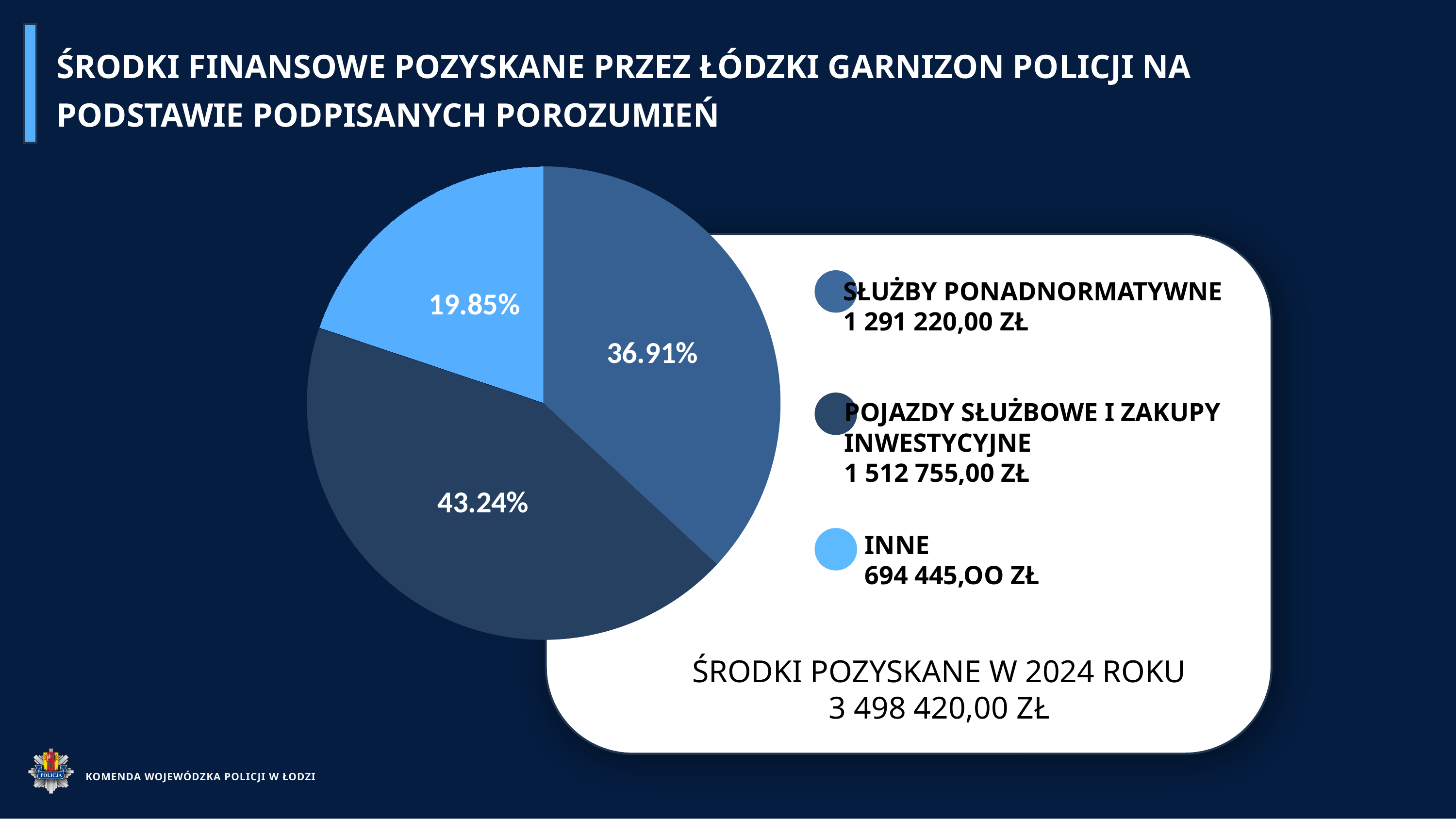
What share of the pie does INNE represent? 19.85% How many slices does the pie chart have? 3 What colour is the INNE slice in the pie chart? light blue Which category has the largest slice of the pie? POJAZDY SŁUŻBOWE I ZAKUPY INWESTYCYJNE What share of the pie does SŁUŻBY PONADNORMATYWNE represent? 36.91% What amount is listed in the legend for SŁUŻBY PONADNORMATYWNE? 1 291 220,00 ZŁ Which is larger: the share for SŁUŻBY PONADNORMATYWNE or the share for INNE? SŁUŻBY PONADNORMATYWNE What share of the pie does POJAZDY SŁUŻBOWE I ZAKUPY INWESTYCYJNE represent? 43.24% What kind of chart is shown on the slide? pie chart Which category has the smallest slice of the pie? INNE What total amount of funds obtained in 2024 is shown on the slide? 3 498 420,00 ZŁ What is the difference in percentage points between the POJAZDY SŁUŻBOWE I ZAKUPY INWESTYCYJNE slice and the INNE slice? 23.39